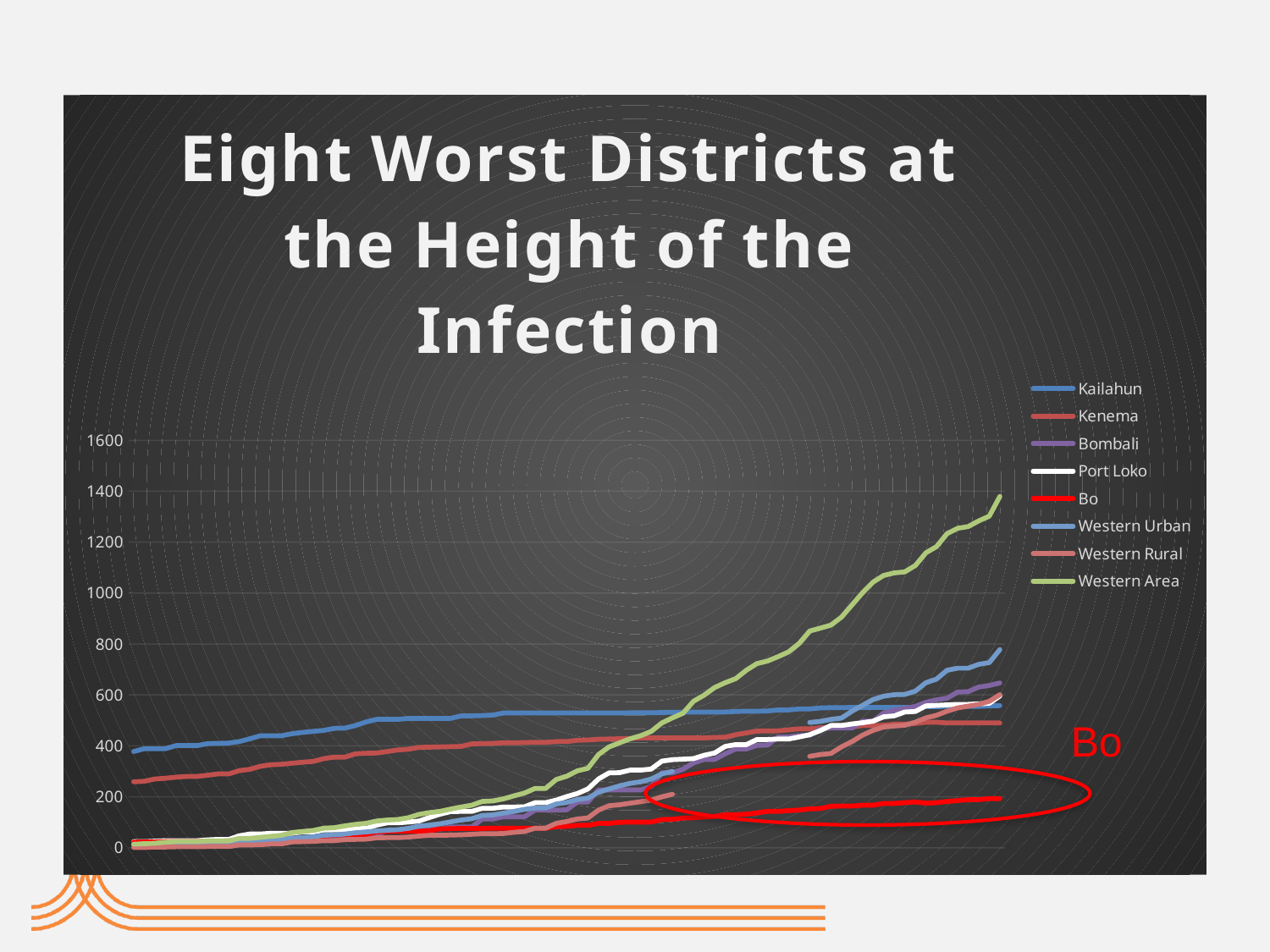
Which series reaches the highest value at the right end of the chart? Western Area What is the title of the chart? Eight Worst Districts at the Height of the Infection Which series has the lowest value at the right end of the chart? Bo At the right end of the chart, which is higher: Western Urban or Kailahun? Western Urban Which series is circled and labelled in red on the chart? Bo How many series does the legend list? 8 Is the final value of the Western Area line greater or less than 1200? greater Does the Western Area line rise or fall along the x axis? rise What kind of chart is shown on the slide? line chart Is the final value of the Bo line greater or less than 400? less At the right end of the chart, which is higher: Western Area or Kenema? Western Area Is the final value of the Kenema line greater or less than 600? less